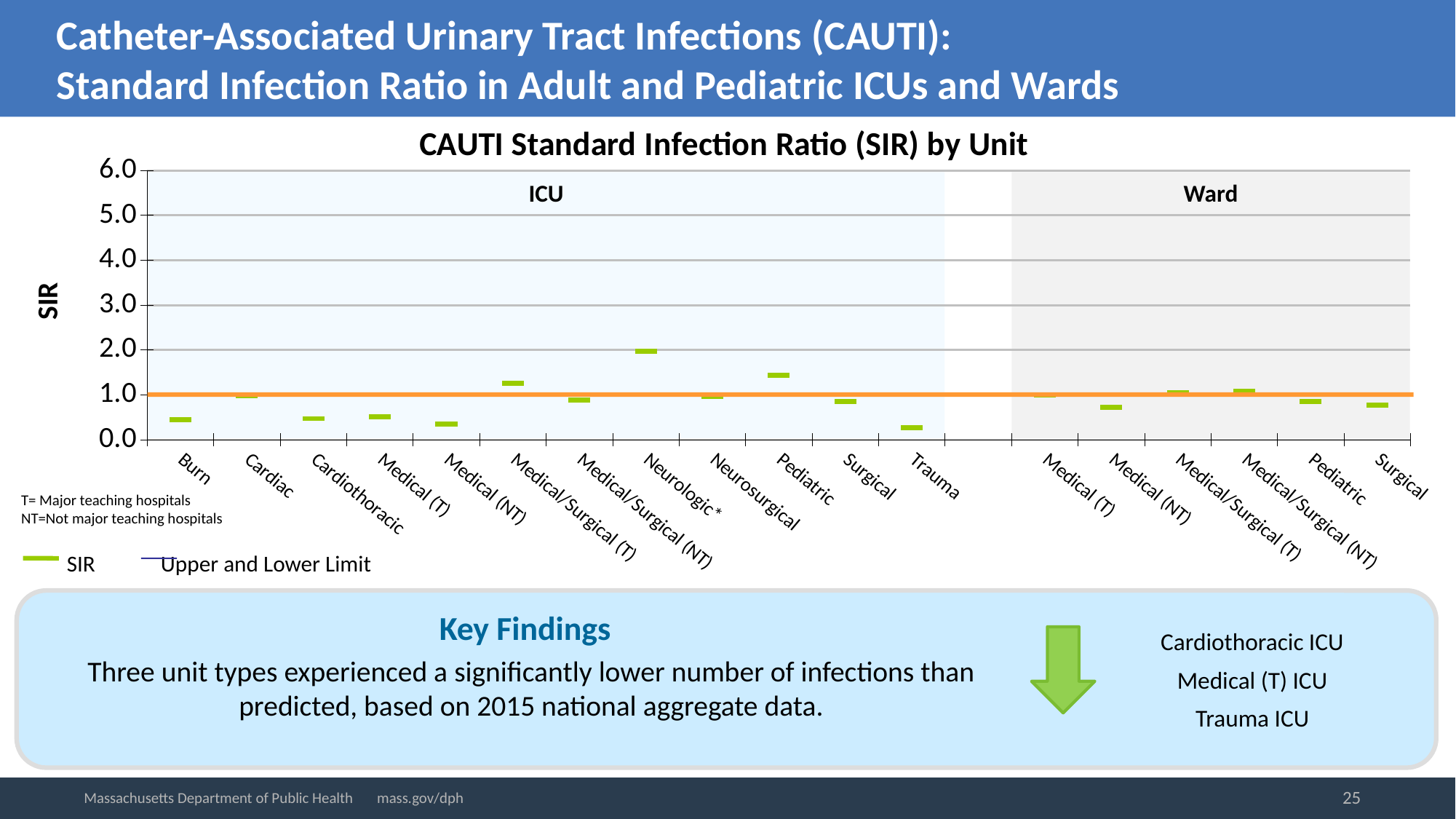
Which unit has the highest SIR on the chart? Neurologic * (ICU) Which has the larger SIR, the Burn ICU or the Trauma ICU? Burn ICU Which has the larger SIR, the Neurologic * ICU or the Pediatric ICU? Neurologic * ICU Is the SIR for the Neurologic * ICU greater or less than 1.0? greater What is the title of the chart? CAUTI Standard Infection Ratio (SIR) by Unit How many unit types are plotted in the Ward section of the chart? 6 Is the SIR for the Trauma ICU greater or less than 1.0? less Is the SIR for the Pediatric ICU greater or less than 1.0? greater How many entries does the chart legend list? 2 How many unit types are plotted in the ICU section of the chart? 12 Which unit has the lowest SIR on the chart? Trauma (ICU)